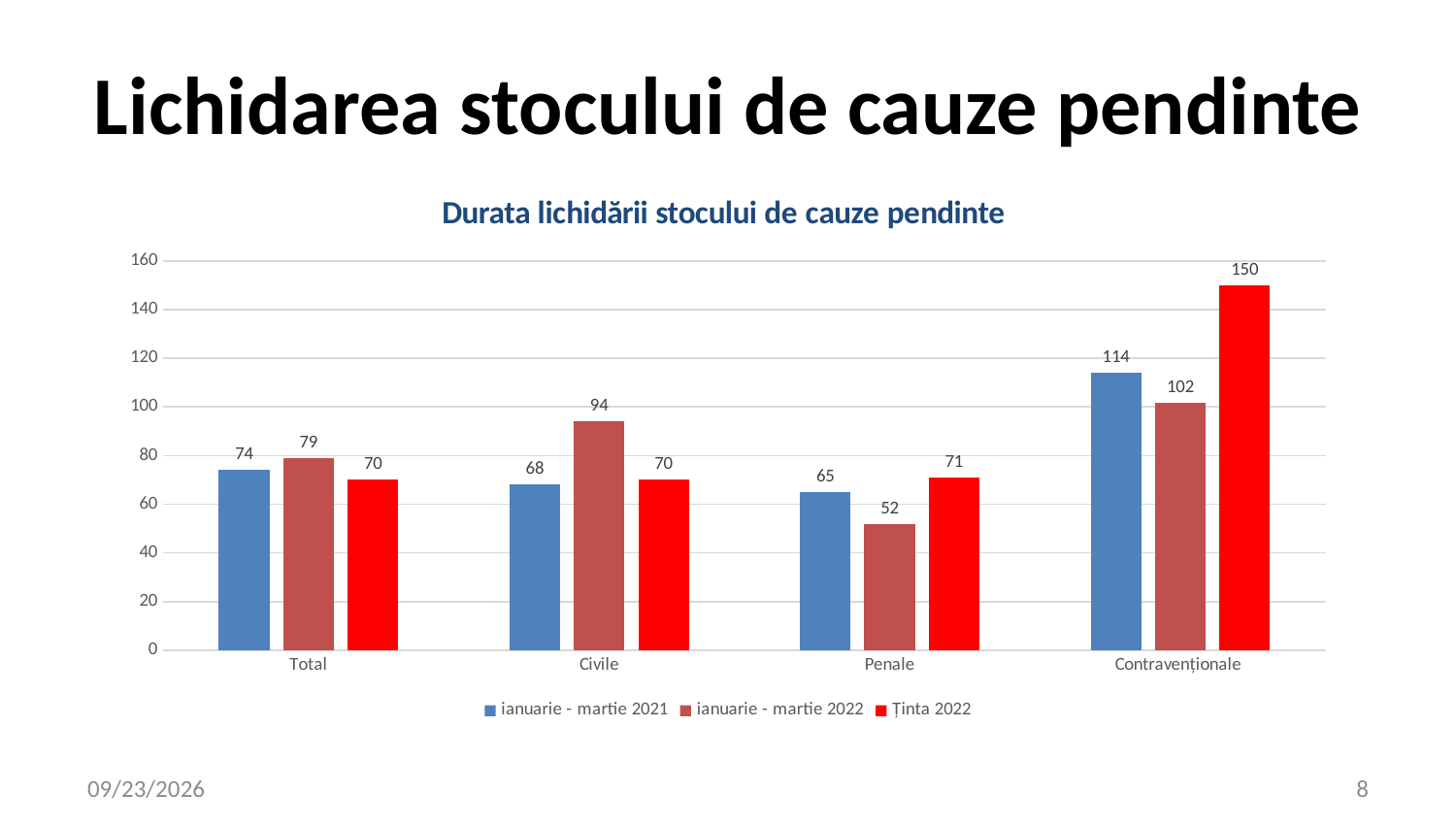
What is the difference between the ianuarie - martie 2021 and ianuarie - martie 2022 values for Contravenționale? 12 How many series does the legend list? 3 What is the difference between the Ținta 2022 value and the ianuarie - martie 2022 value for Penale? 19 How many categories are shown on the x axis? 4 What kind of chart is shown on the slide? Bar chart What is the Ținta 2022 value for Contravenționale? 150 For Civile, which is larger: the ianuarie - martie 2022 value or the Ținta 2022 value? ianuarie - martie 2022 What is the value for Civile in the ianuarie - martie 2022 series? 94 What is the value for Penale in the ianuarie - martie 2021 series? 65 Which category has the highest value in the ianuarie - martie 2022 series? Contravenționale Which category has the lowest value in the ianuarie - martie 2022 series? Penale What is the title of the chart? Durata lichidării stocului de cauze pendinte